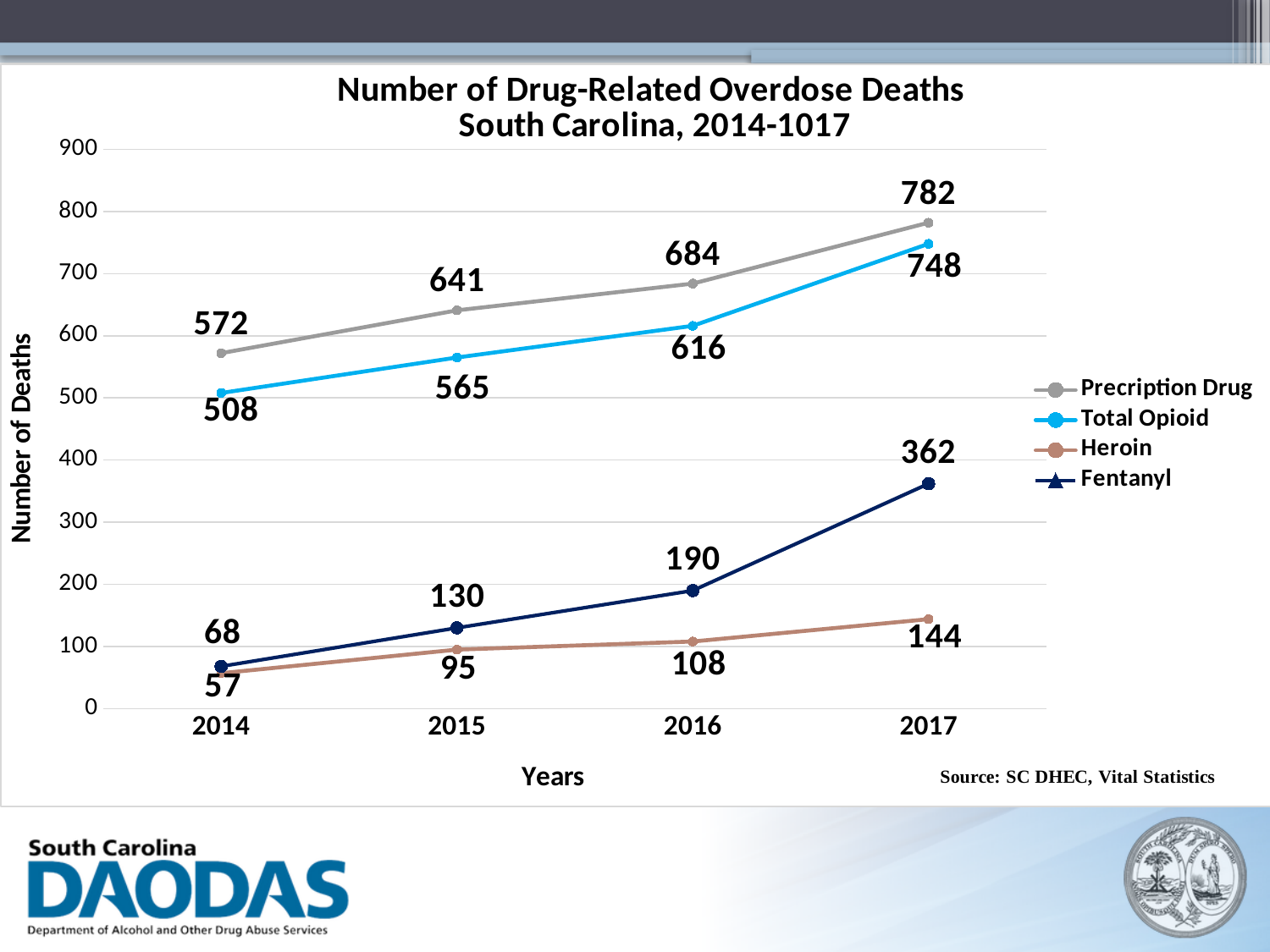
In which year were Heroin overdose deaths lowest? 2014 In which year were Fentanyl overdose deaths highest? 2017 What was the number of Total Opioid overdose deaths in 2014? 508 How many series does the legend list? 4 Do Total Opioid overdose deaths rise or fall from 2014 to 2017? rise What type of chart is shown on the slide? line chart Which was larger in 2014: Fentanyl deaths or Heroin deaths? Fentanyl What was the number of Prescription Drug overdose deaths in 2017? 782 How many years are shown on the x axis? 4 What was the number of Heroin overdose deaths in 2015? 95 What is the difference between Prescription Drug deaths and Total Opioid deaths in 2017? 34 What was the number of Fentanyl overdose deaths in 2016? 190